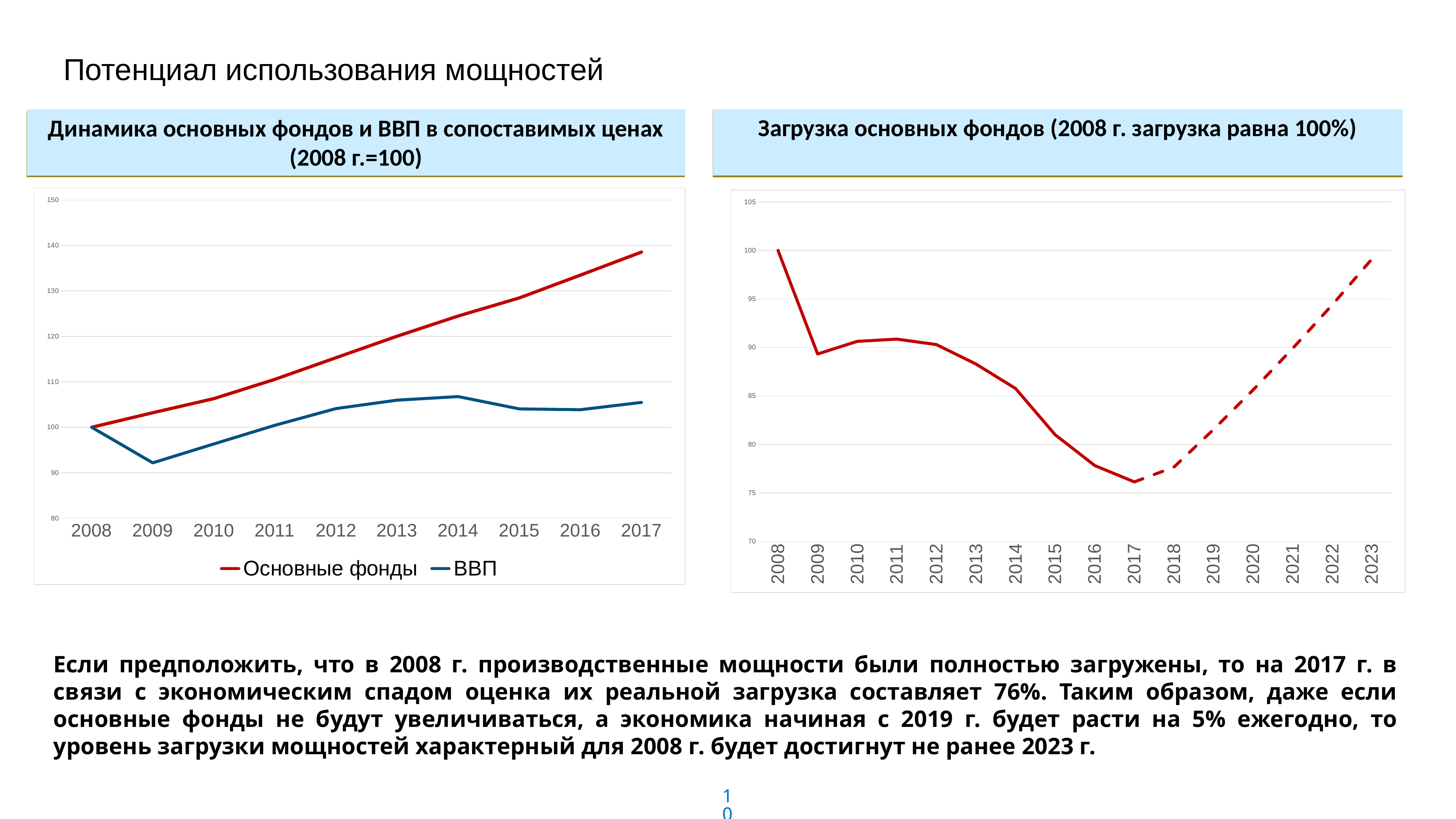
In the left chart, what is the value of 'Основные фонды' in 2008? 100 How many series does the legend of the left chart list? 2 In the left chart, is the value of 'ВВП' in 2009 greater or less than 100? less How many years are shown on the x axis of the right chart, 'Загрузка основных фондов'? 16 In the right chart, which year has the lowest value? 2017 In the left chart, is the value of 'Основные фонды' in 2017 greater or less than 130? greater How many years are shown on the x axis of the left chart? 10 What kind of chart is the left chart, 'Динамика основных фондов и ВВП в сопоставимых ценах (2008 г.=100)'? line chart In the left chart, which series has the higher value in 2017, 'Основные фонды' or 'ВВП'? Основные фонды In the right chart, what is the value for 2008? 100 In the left chart, does the 'Основные фонды' line rise or fall from 2008 to 2017? rise In the right chart, is the value for 2017 greater or less than 80? less